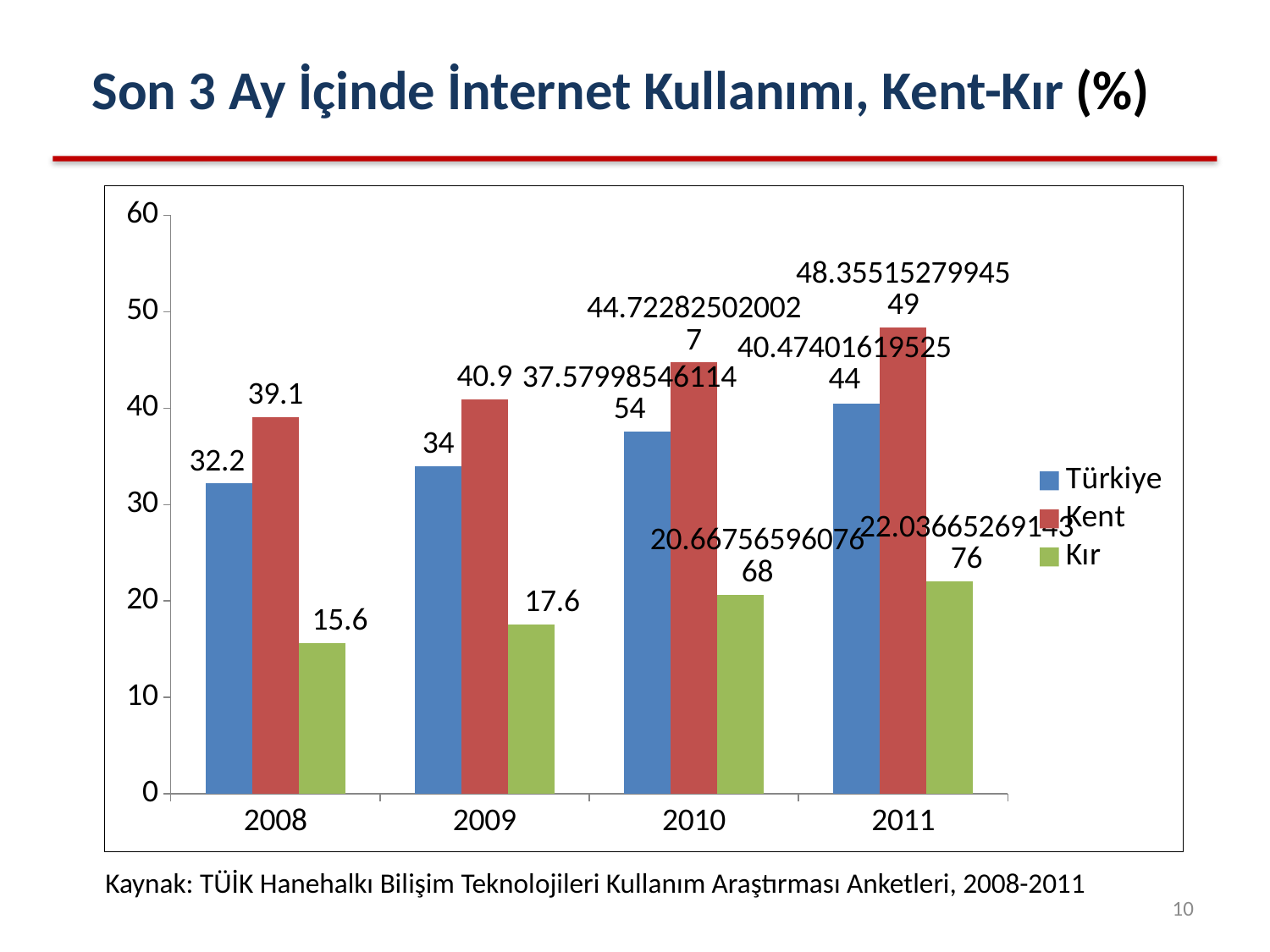
Is the value for Kent in 2010 greater or less than 40? greater What is the value for Kır in 2008? 15.6 What is the value for Kent in 2009? 40.9 What is the value for Kır in 2009? 17.6 What is the value for Türkiye in 2008? 32.2 What type of chart is shown on the slide? bar chart How many series does the legend list? 3 How many years are shown on the x axis? 4 Which series has the highest value in 2011? Kent Does the Türkiye series rise or fall from 2008 to 2011? rise Which year has the lowest value for Kır? 2008 What is the difference between the Kent and Türkiye values in 2008? 6.9